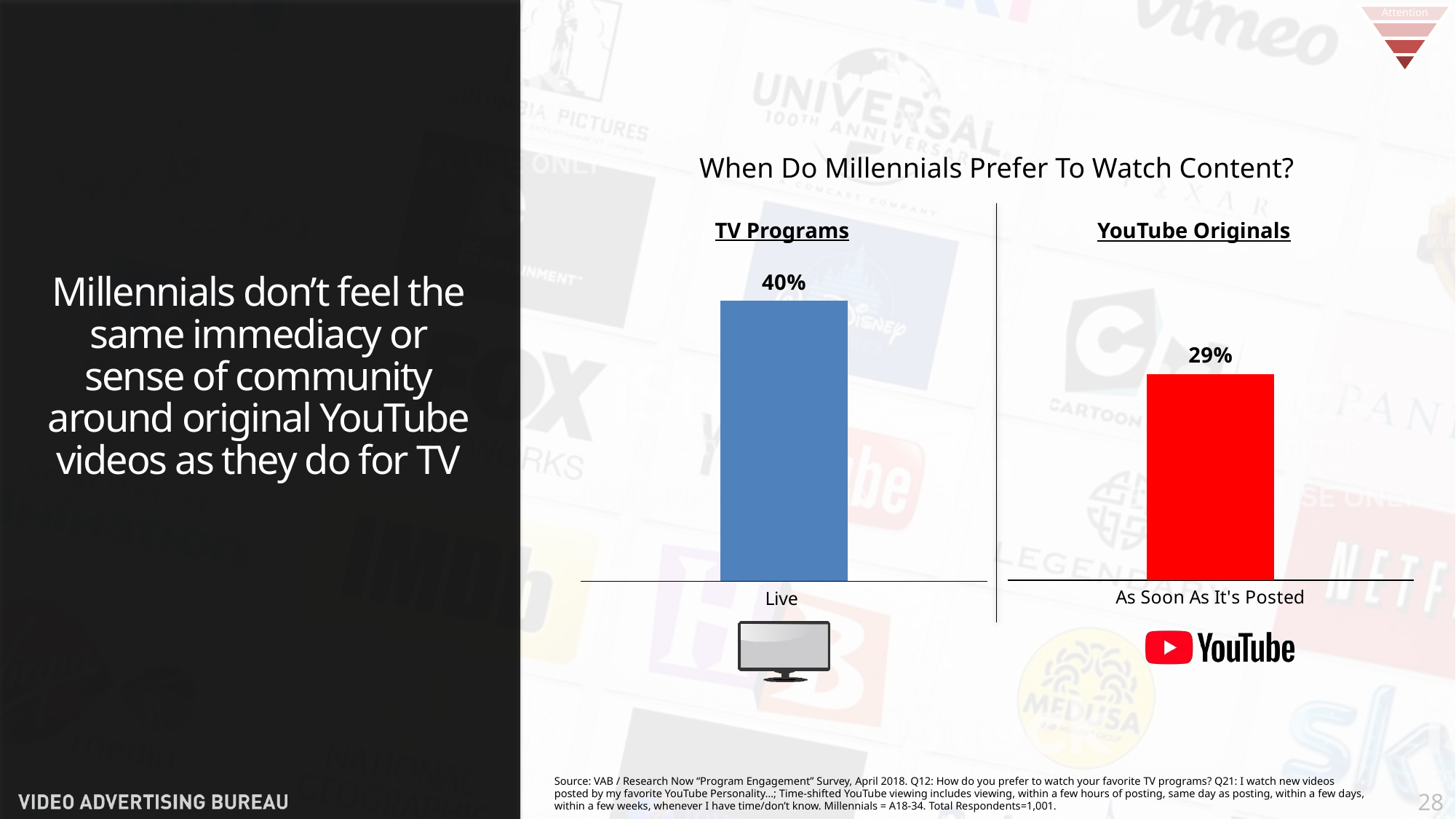
What kind of chart is the YouTube Originals chart? Bar chart Which is larger: the Live value in the TV Programs chart or the As Soon As It's Posted value in the YouTube Originals chart? Live (TV Programs) What is the category label of the bar in the YouTube Originals chart? As Soon As It's Posted How many bars are in the YouTube Originals chart? 1 What colour is the bar in the YouTube Originals chart? Red In the TV Programs chart, what is the value for Live? 40% How many bars are in the TV Programs chart? 1 What is the difference between the Live value in the TV Programs chart and the As Soon As It's Posted value in the YouTube Originals chart? 11% What kind of chart is the TV Programs chart? Bar chart In the YouTube Originals chart, what is the value for As Soon As It's Posted? 29% What is the title shown above the two charts? When Do Millennials Prefer To Watch Content?